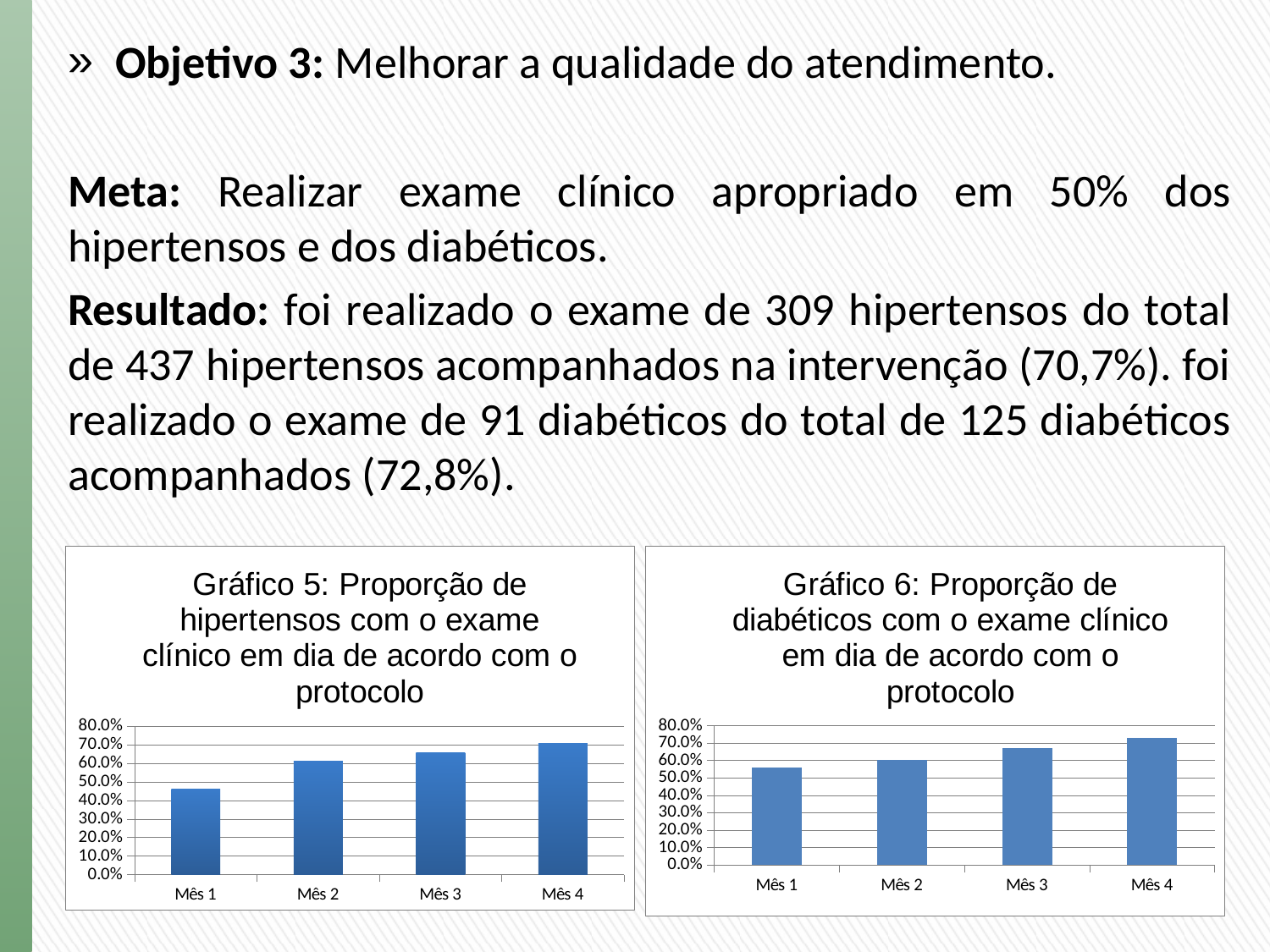
In Gráfico 5, which month has the highest proportion? Mês 4 In Gráfico 5, which is larger, the value for Mês 1 or the value for Mês 2? Mês 2 In Gráfico 5, which month has the lowest proportion? Mês 1 In Gráfico 6, which month has the lowest proportion? Mês 1 What is the title of the chart on the right side of the slide? Gráfico 6: Proporção de diabéticos com o exame clínico em dia de acordo com o protocolo In Gráfico 5, do the values rise or fall from Mês 1 to Mês 4? rise How many categories are shown on the x axis of Gráfico 6? 4 In Gráfico 6, which month has the highest proportion? Mês 4 In Gráfico 6, is the value for Mês 4 greater or less than 70.0%? greater What kind of chart is Gráfico 5? bar chart In Gráfico 6, do the values rise or fall from Mês 1 to Mês 4? rise In Gráfico 5, is the value for Mês 1 greater or less than 50.0%? less